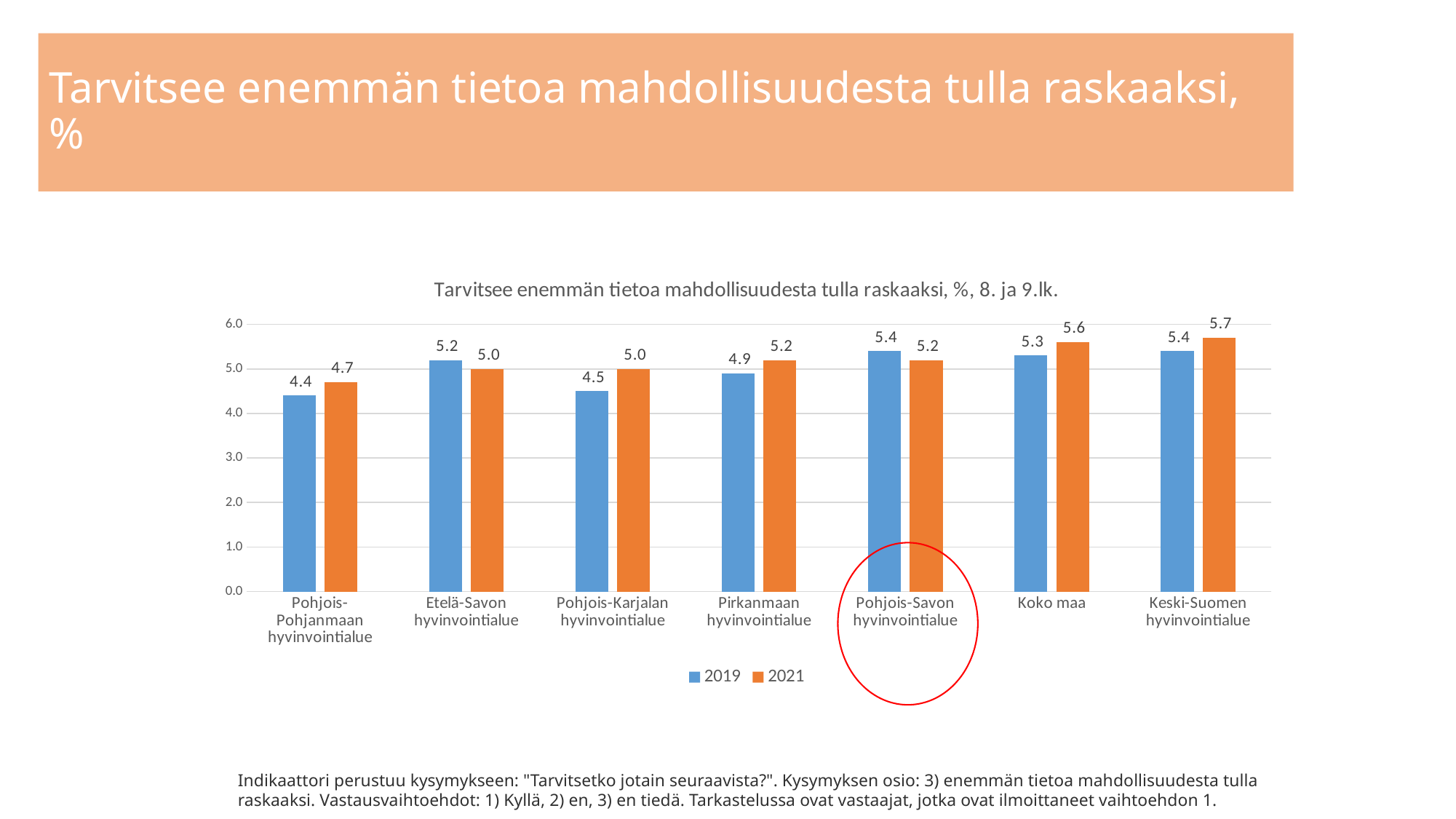
What is the 2019 value for Pohjois-Savon hyvinvointialue? 5.4 How many series does the legend list? 2 What is the 2021 value for Pohjois-Karjalan hyvinvointialue? 5.0 Which is larger for Etelä-Savon hyvinvointialue, the 2019 value or the 2021 value? 2019 How many categories are shown on the x axis? 7 Which category is circled in red on the chart? Pohjois-Savon hyvinvointialue What is the difference between the 2021 and 2019 values for Pohjois-Karjalan hyvinvointialue? 0.5 Is the 2019 value for Pirkanmaan hyvinvointialue greater or less than 5.0? less What is the 2021 value for Koko maa? 5.6 What kind of chart is shown on the slide? bar chart Which category has the highest 2021 value? Keski-Suomen hyvinvointialue Which category has the lowest 2019 value? Pohjois-Pohjanmaan hyvinvointialue